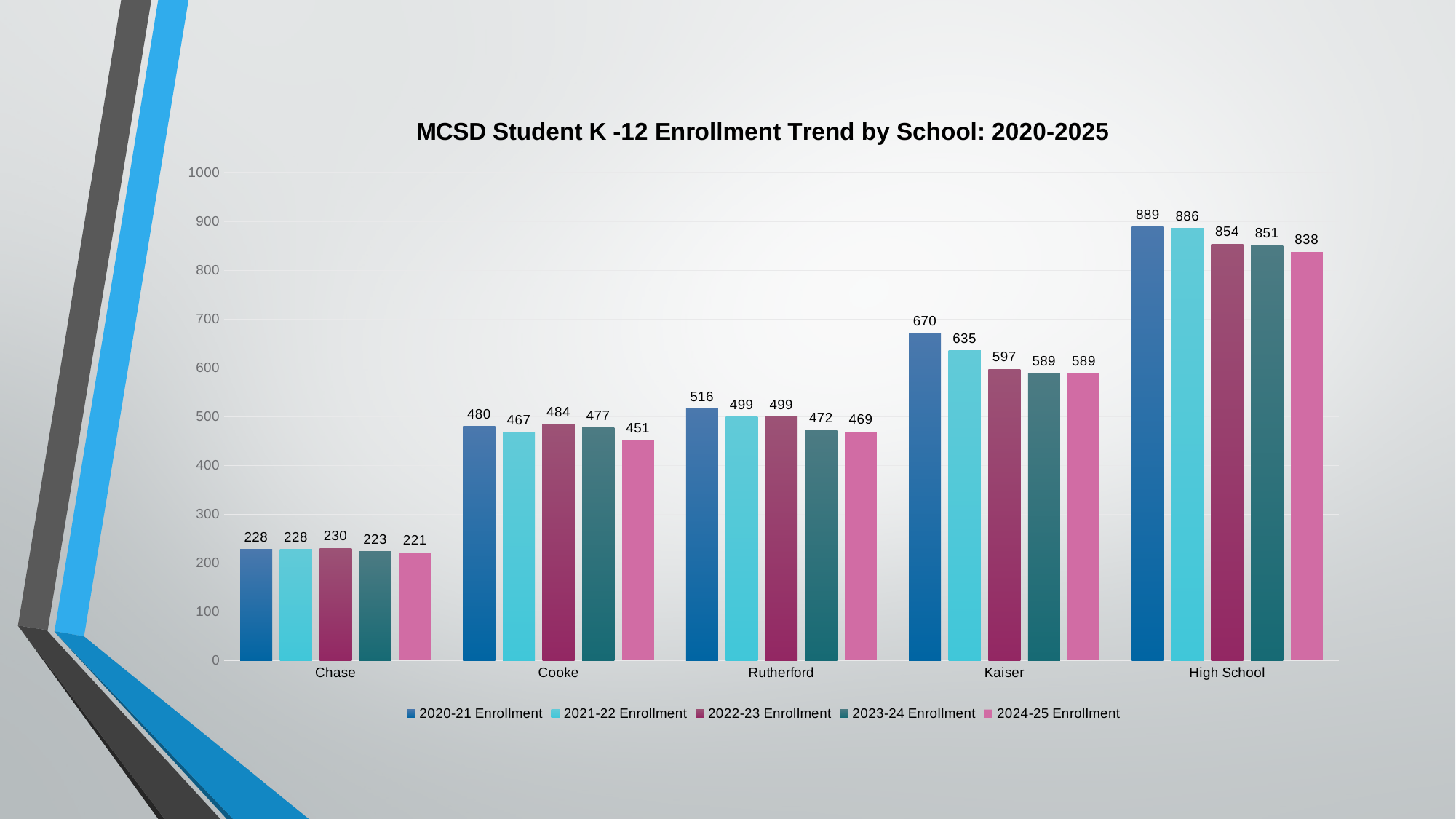
What is the 2024-25 Enrollment value for Cooke? 451 Which school has the highest 2020-21 Enrollment? High School Which is larger: the 2021-22 Enrollment for Rutherford or the 2021-22 Enrollment for Cooke? Rutherford How many schools are shown on the x axis? 5 What kind of chart is shown on the slide? Bar chart What is the title of the chart? MCSD Student K -12 Enrollment Trend by School: 2020-2025 Do the enrollment values for Kaiser rise or fall from 2020-21 to 2024-25? Fall What is the 2020-21 Enrollment value for Kaiser? 670 How many series does the legend list? 5 What is the 2022-23 Enrollment value for Chase? 230 Which school has the lowest 2024-25 Enrollment? Chase What is the difference between the 2020-21 and 2024-25 Enrollment values for High School? 51